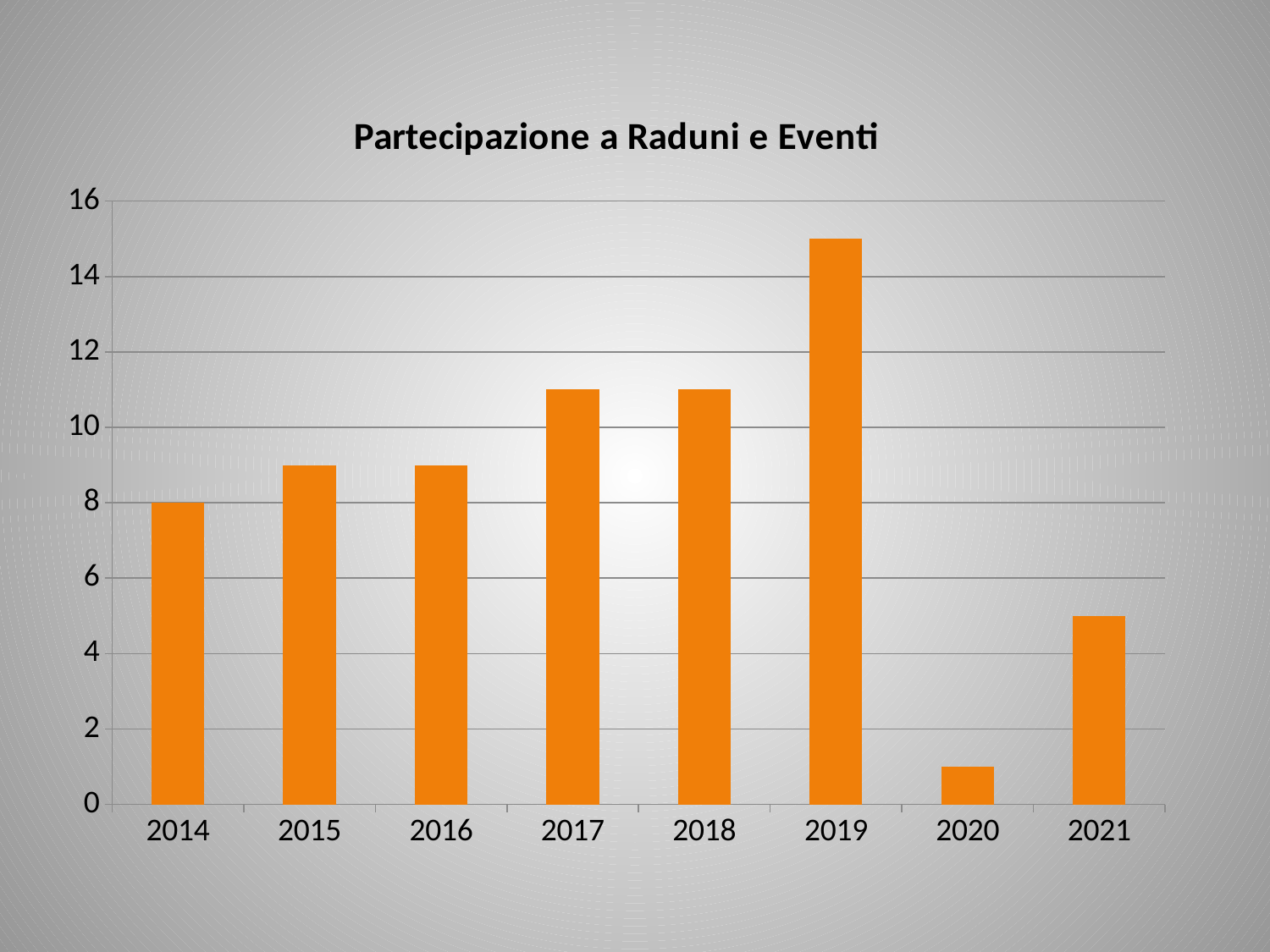
Which year has the highest value in the chart? 2019 Is the value for 2019 greater or less than 14? greater Is the value for 2021 greater or less than 6? less What is the value for 2014? 8 What is the title of the chart? Partecipazione a Raduni e Eventi How many years are shown on the x axis of the chart? 8 Do the values rise or fall from 2014 to 2017? rise Is the value for 2017 greater or less than 10? greater Which is larger, the value for 2018 or the value for 2021? 2018 Which year has the lowest value in the chart? 2020 What kind of chart is shown on the slide? bar chart